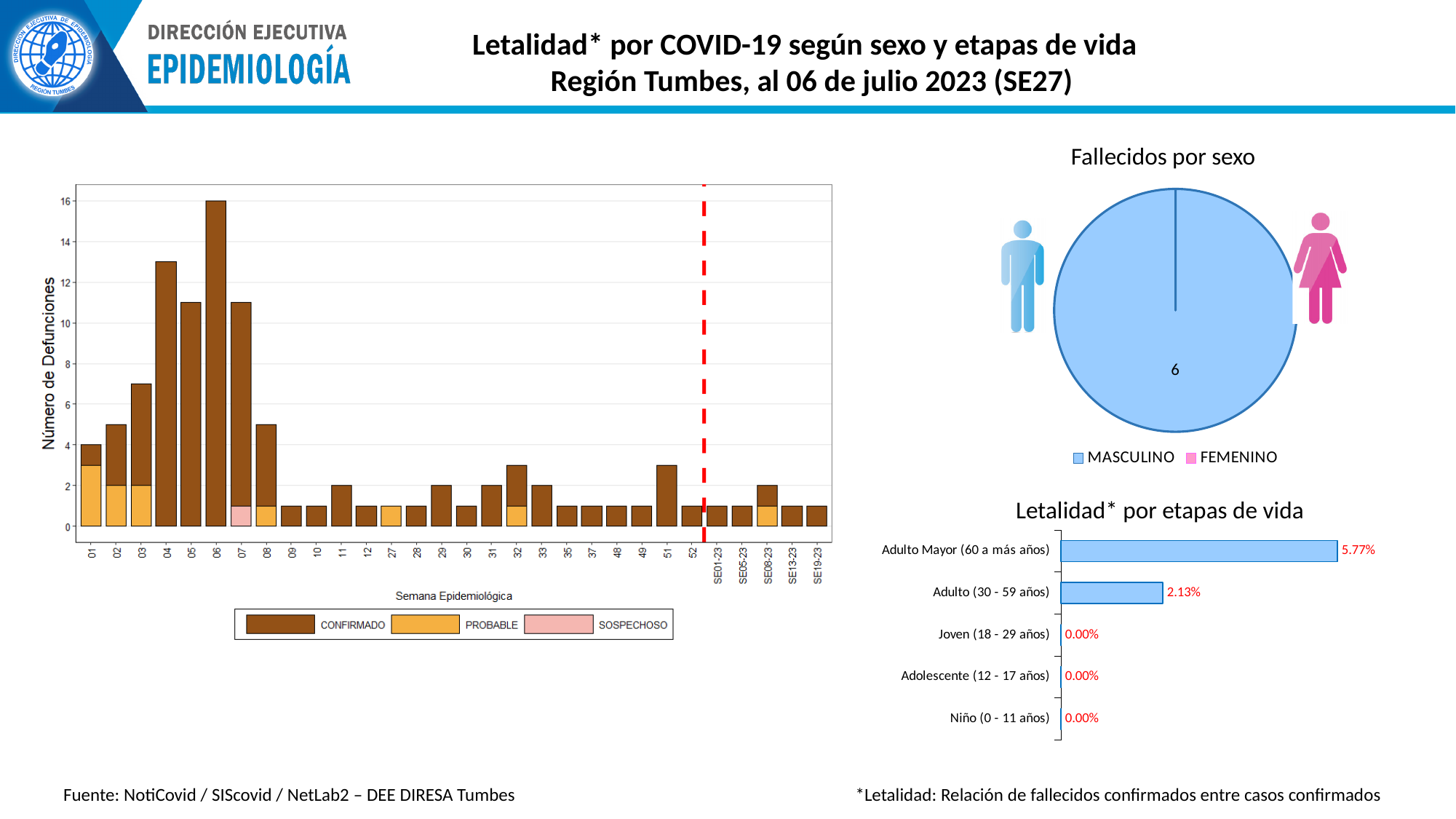
What kind of chart is 'Letalidad* por etapas de vida'? Bar chart How many categories are shown in the 'Letalidad* por etapas de vida' chart? 5 In the 'Letalidad* por etapas de vida' chart, what is the value for Joven (18 - 29 años)? 0.00% In the 'Letalidad* por etapas de vida' chart, what is the value for Adulto Mayor (60 a más años)? 5.77% In the 'Fallecidos por sexo' chart, what value is shown for MASCULINO? 6 In the 'Letalidad* por etapas de vida' chart, what is the value for Adulto (30 - 59 años)? 2.13% In the bar chart on the left (Número de Defunciones by Semana Epidemiológica), what is the total number of deaths for week 06? 16 In the bar chart on the left (Número de Defunciones by Semana Epidemiológica), how many series does the legend list? 3 In the 'Letalidad* por etapas de vida' chart, which category has the highest value? Adulto Mayor (60 a más años) In the 'Letalidad* por etapas de vida' chart, what is the difference between the values for Adulto Mayor (60 a más años) and Adulto (30 - 59 años)? 3.64% How many series does the legend of the 'Fallecidos por sexo' chart list? 2 In the bar chart on the left (Número de Defunciones by Semana Epidemiológica), is the total for week 04 greater or less than 12? greater